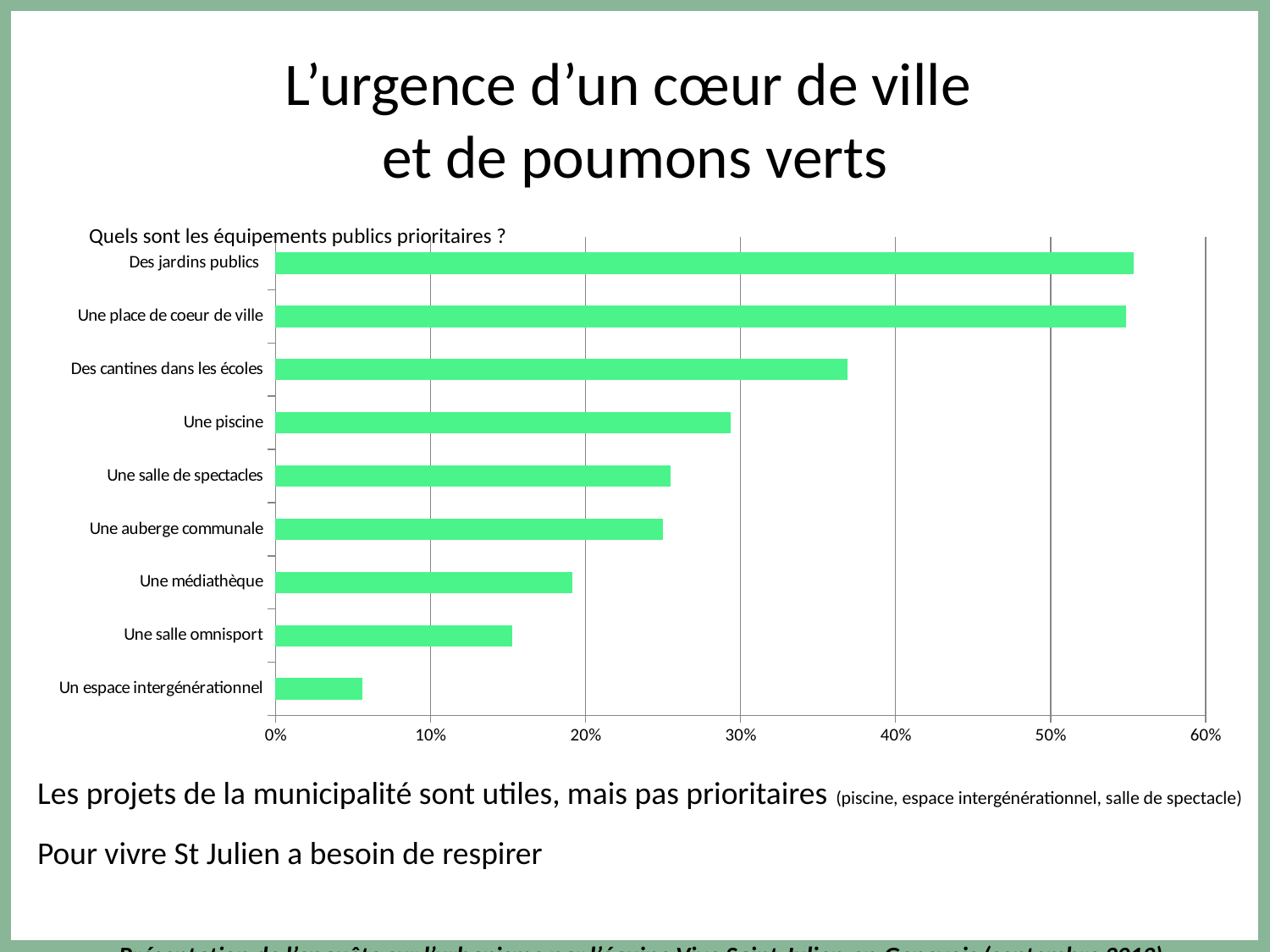
Do the bar values increase or decrease going from the top category to the bottom category? decrease Which is larger, the value for Une médiathèque or the value for Une salle omnisport? Une médiathèque Which is larger, the value for Des cantines dans les écoles or the value for Une piscine? Des cantines dans les écoles What kind of chart is shown on the slide? Bar chart How many categories (équipements) are shown in the chart? 9 Is the value for Une salle omnisport greater or less than 10%? greater Is the value for Un espace intergénérationnel greater or less than 10%? less Which category has the lowest value in the chart? Un espace intergénérationnel Is the value for Des jardins publics greater or less than 50%? greater What is the title of the chart? Quels sont les équipements publics prioritaires ?